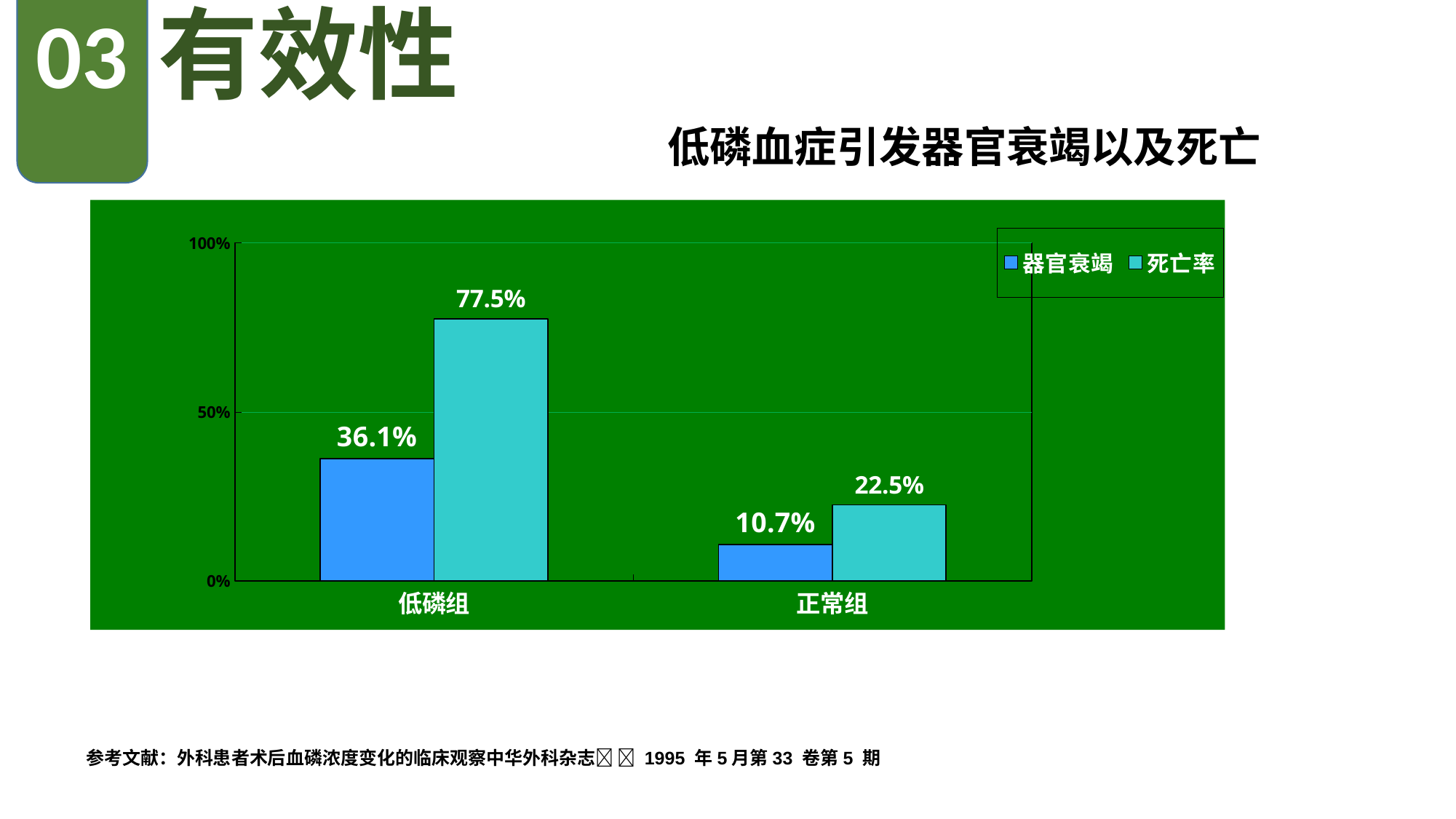
Is the 死亡率 value for 低磷组 greater or less than 50%? greater What is the 器官衰竭 value for 低磷组? 36.1% How many groups are shown on the x axis? 2 Which group has the lowest 器官衰竭 value? 正常组 What is the 器官衰竭 value for 正常组? 10.7% Which group has the highest 死亡率? 低磷组 What is the 死亡率 value for 正常组? 22.5% How many series does the legend list? 2 What kind of chart is shown on the slide? bar chart What is the 死亡率 value for 低磷组? 77.5% What is the difference between the 死亡率 values of 低磷组 and 正常组? 55.0% Which is larger for 低磷组: 器官衰竭 or 死亡率? 死亡率